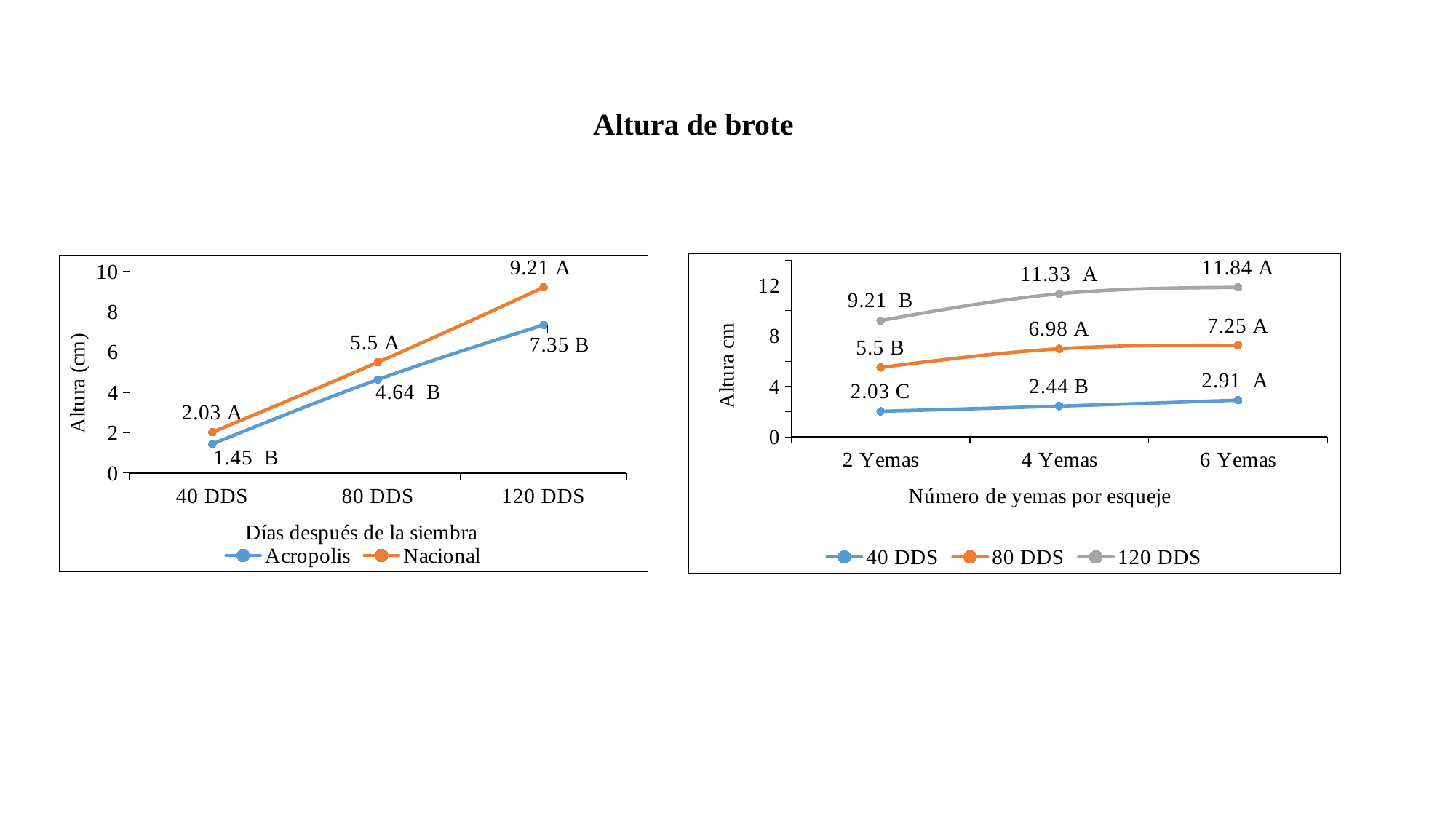
In the right chart, which category has the highest value for the 80 DDS series? 6 Yemas In the left chart, what is the value for Acropolis at 40 DDS? 1.45 In the left chart, what is the value for Nacional at 120 DDS? 9.21 In the right chart, what is the label of the x axis? Número de yemas por esqueje In the left chart, how many series does the legend list? 2 In the right chart, how many series does the legend list? 3 What kind of chart is the left chart? line chart In the left chart, what is the difference between Nacional and Acropolis at 80 DDS? 0.86 In the left chart, which series is higher at 120 DDS, Acropolis or Nacional? Nacional In the right chart, what is the value for 40 DDS at 2 Yemas? 2.03 In the left chart, do the values for Acropolis rise or fall from 40 DDS to 120 DDS? rise In the right chart, what is the value for 120 DDS at 6 Yemas? 11.84